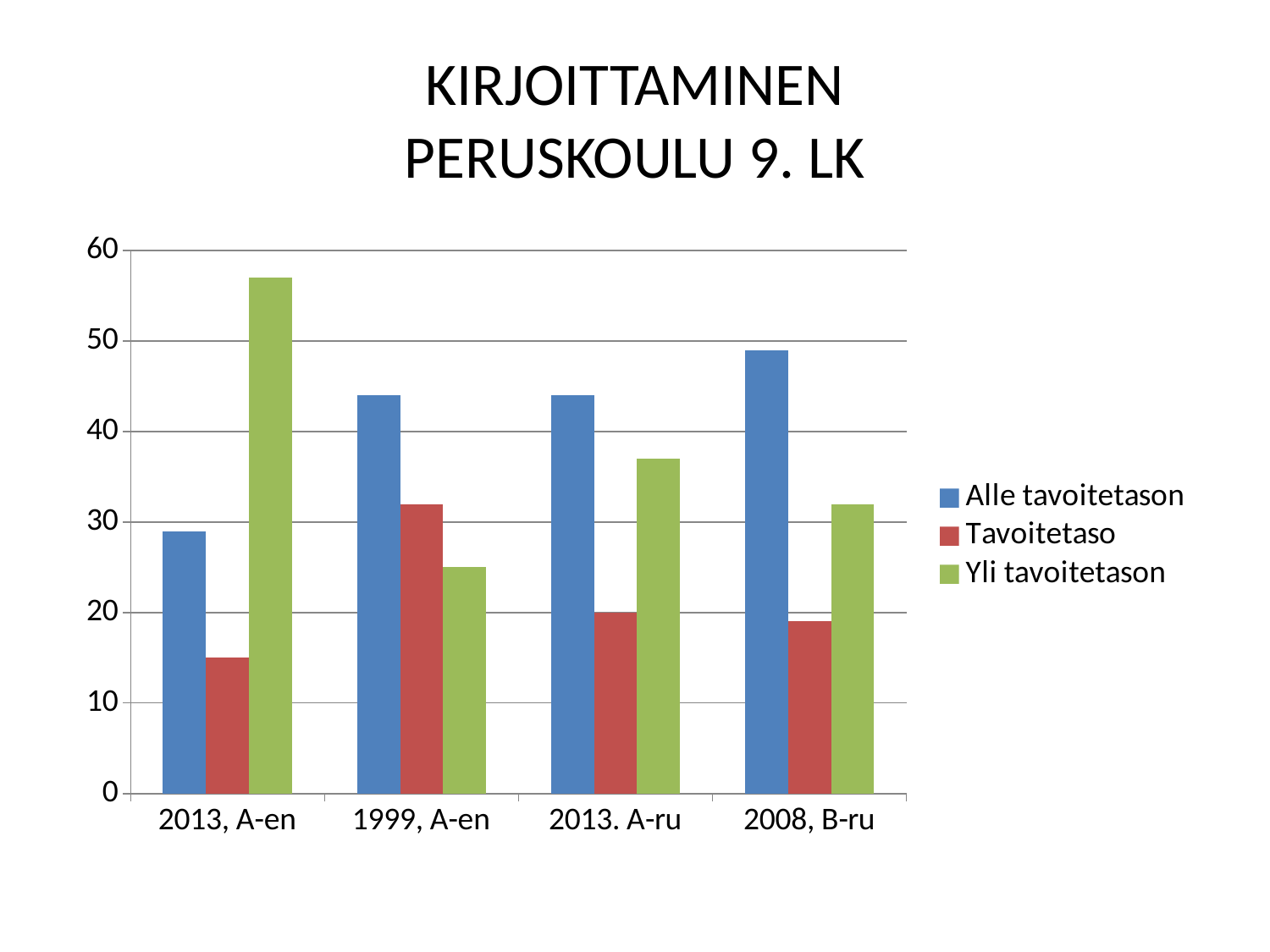
How many categories are shown on the x axis? 4 What kind of chart is shown on the slide? bar chart How many series does the legend list? 3 Is the Tavoitetaso value for 1999, A-en greater or less than 30? greater Which is larger for 1999, A-en: Alle tavoitetason or Yli tavoitetason? Alle tavoitetason Which category has the highest Yli tavoitetason value? 2013, A-en What colour are the Tavoitetaso bars? red Which is larger for 2013. A-ru: Tavoitetaso or Yli tavoitetason? Yli tavoitetason Which category has the lowest Tavoitetaso value? 2013, A-en Is the Yli tavoitetason value for 2013, A-en greater or less than 50? greater Which category has the highest Alle tavoitetason value? 2008, B-ru